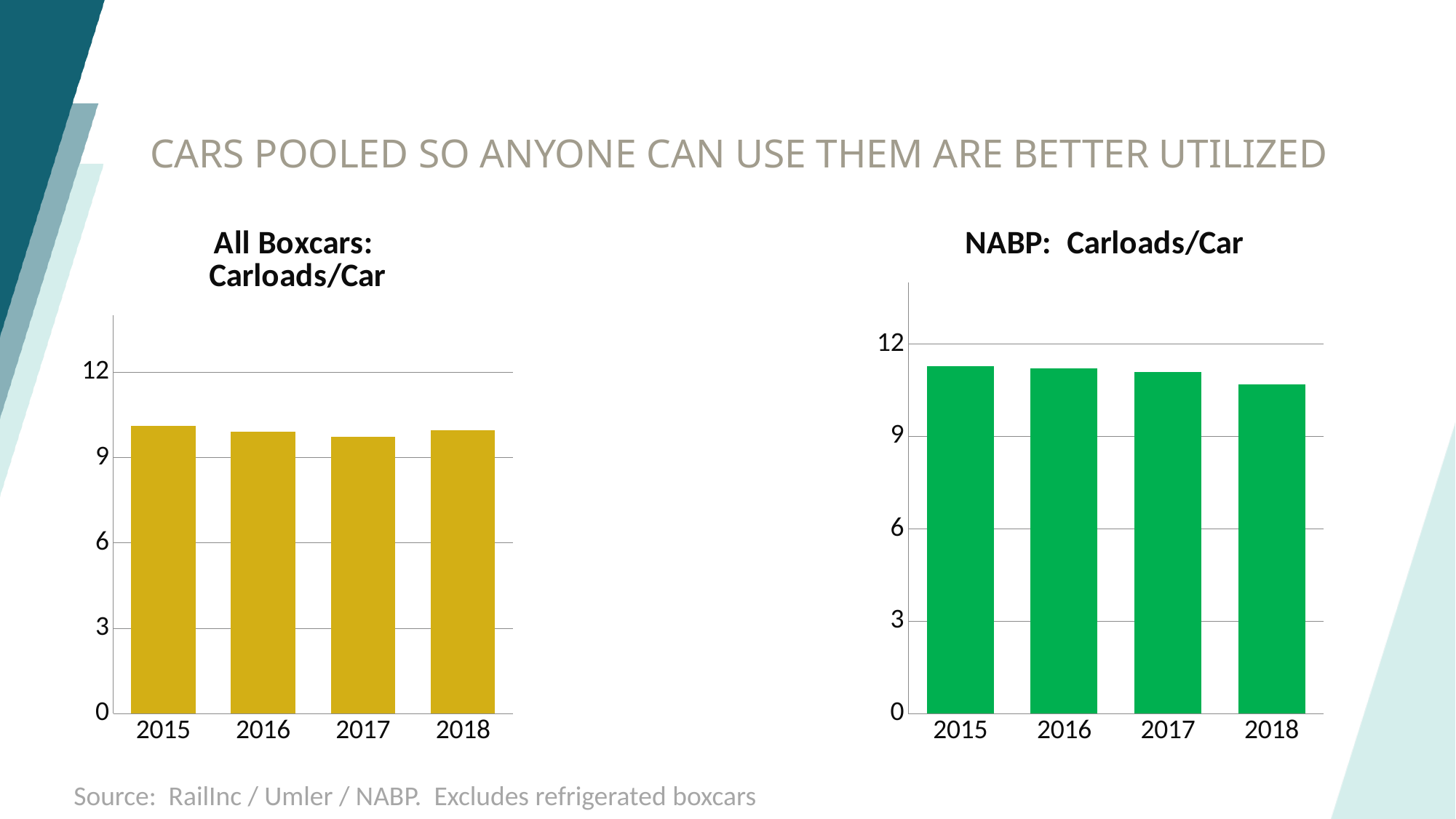
On the 'All Boxcars: Carloads/Car' chart, is the value for 2017 greater or less than 12? less On the 'NABP: Carloads/Car' chart, which is larger, the value for 2015 or the value for 2018? 2015 On the 'NABP: Carloads/Car' chart, do the values rise or fall from 2015 to 2018? fall On the 'All Boxcars: Carloads/Car' chart, which year has the lowest value? 2017 On the 'NABP: Carloads/Car' chart, is the value for 2018 greater or less than 12? less What kind of chart is the 'All Boxcars: Carloads/Car' chart? bar chart On the 'NABP: Carloads/Car' chart, which year has the lowest value? 2018 On the 'NABP: Carloads/Car' chart, is the value for 2015 greater or less than 9? greater How many years are shown on the 'NABP: Carloads/Car' chart? 4 On the 'All Boxcars: Carloads/Car' chart, which is larger, the value for 2015 or the value for 2017? 2015 What colour are the bars on the 'NABP: Carloads/Car' chart? green